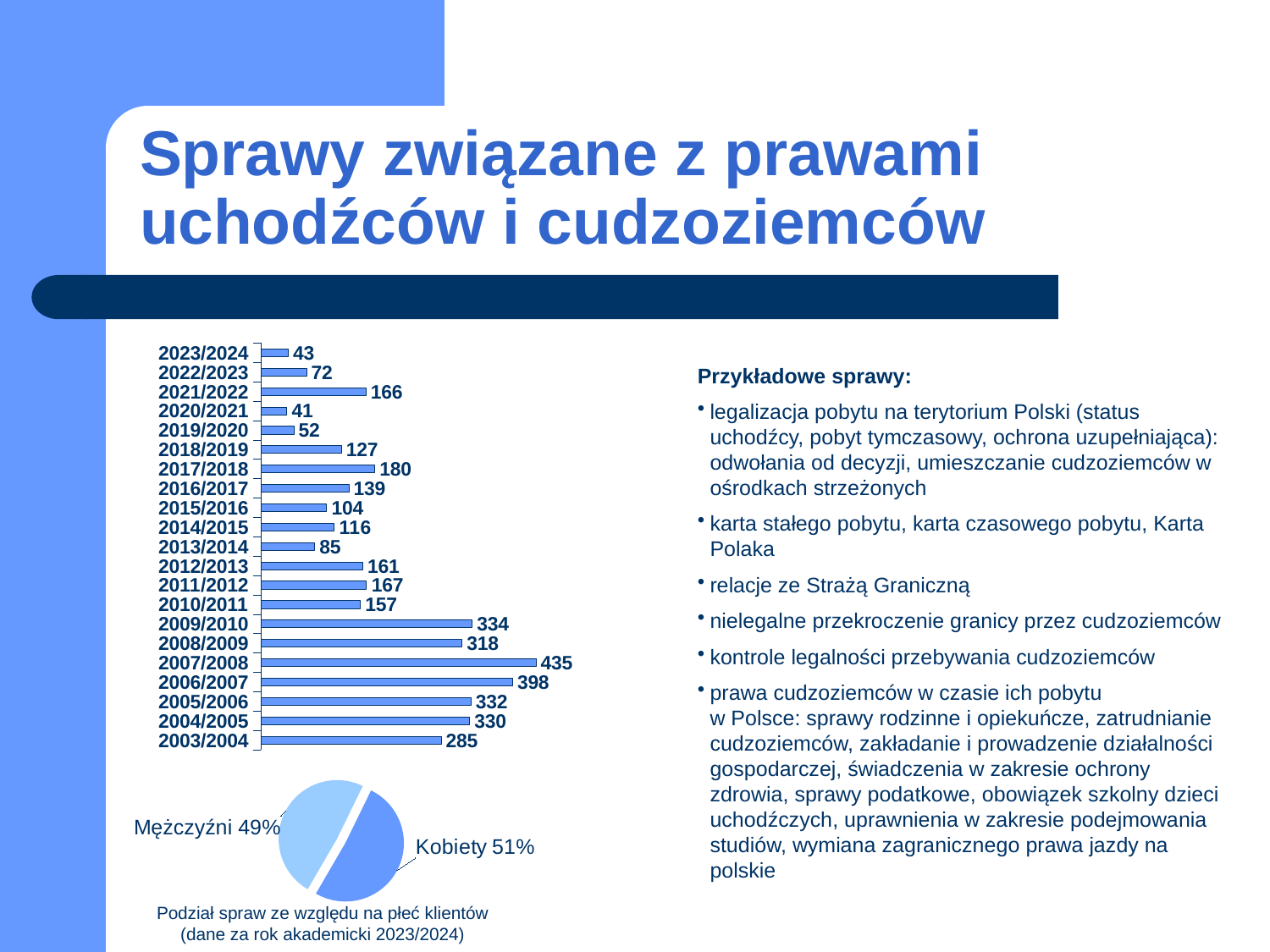
In the bar chart on the left, what is the value for 2023/2024? 43 In the bar chart on the left, what is the value for 2017/2018? 180 In the bar chart on the left, what is the difference between the values for 2009/2010 and 2008/2009? 16 In the bar chart on the left, which is larger, the value for 2021/2022 or the value for 2022/2023? 2021/2022 In the pie chart at the bottom left, what share is labelled Kobiety? 51% In the pie chart at the bottom left, what share is labelled Mężczyźni? 49% How many academic years are shown in the bar chart on the left? 21 What kind of chart is the upper chart on the left of the slide? bar chart In the bar chart on the left, which academic year has the lowest value? 2020/2021 What kind of chart is the lower chart on the left of the slide? pie chart In the bar chart on the left, what is the value for 2007/2008? 435 In the bar chart on the left, which academic year has the highest value? 2007/2008